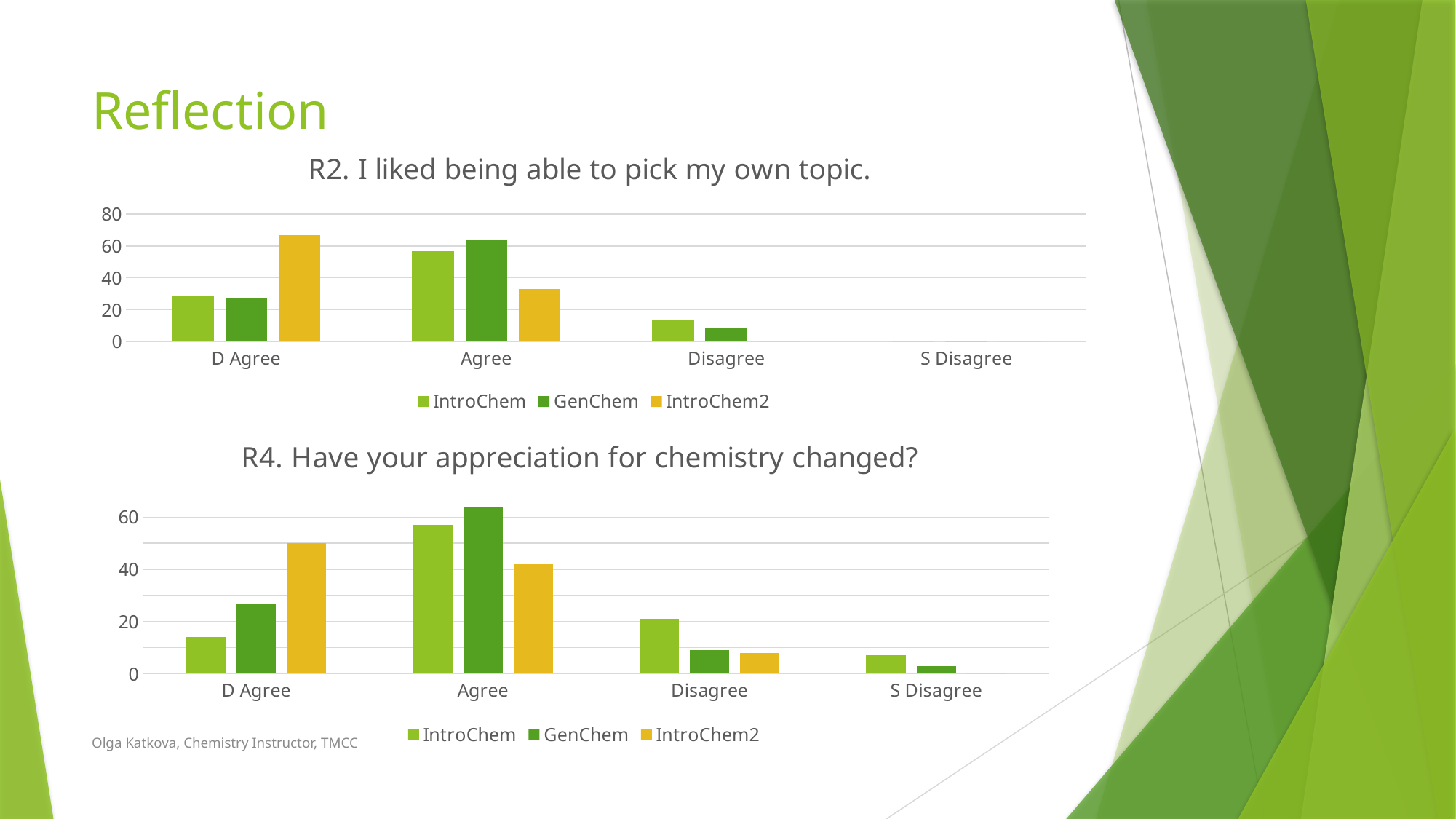
In the "R2. I liked being able to pick my own topic." chart, is the IntroChem value for Disagree greater or less than 20? less In the "R4. Have your appreciation for chemistry changed?" chart, is the IntroChem2 value for D Agree greater or less than 40? greater In the "R4. Have your appreciation for chemistry changed?" chart, which category has the lowest GenChem bar? S Disagree In the "R2. I liked being able to pick my own topic." chart, which category has the highest IntroChem2 bar? D Agree In the "R4. Have your appreciation for chemistry changed?" chart, which series has the highest bar for Agree? GenChem In the "R4. Have your appreciation for chemistry changed?" chart, for D Agree, which is larger: IntroChem or GenChem? GenChem In the "R2. I liked being able to pick my own topic." chart, is the IntroChem2 value for D Agree greater or less than 60? greater In the "R4. Have your appreciation for chemistry changed?" chart, how many categories are shown on the x axis? 4 In the "R2. I liked being able to pick my own topic." chart, how many series does the legend list? 3 What are the legend entries in the "R4. Have your appreciation for chemistry changed?" chart? IntroChem, GenChem, IntroChem2 In the "R2. I liked being able to pick my own topic." chart, for Agree, which is larger: IntroChem or GenChem? GenChem What kind of chart is the "R2. I liked being able to pick my own topic." chart? bar chart